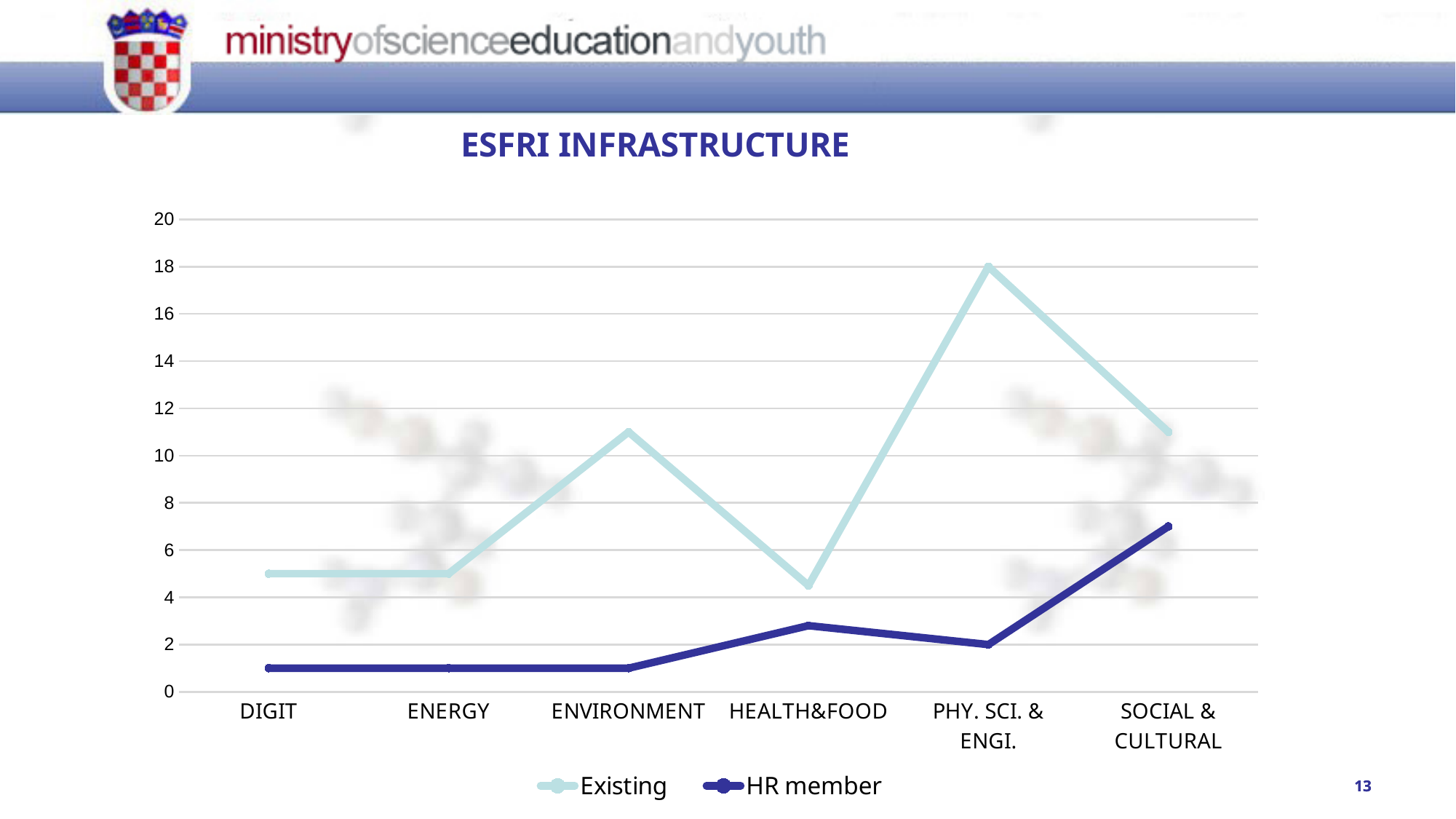
What kind of chart is shown on the slide? Line chart Which category has the highest Existing value? PHY. SCI. & ENGI. For SOCIAL & CULTURAL, which series has the larger value, Existing or HR member? Existing What is the HR member value for PHY. SCI. & ENGI.? 2 What is the Existing value for PHY. SCI. & ENGI.? 18 Does the HR member line rise or fall from PHY. SCI. & ENGI. to SOCIAL & CULTURAL? Rises What is the title of the chart? ESFRI INFRASTRUCTURE How many categories are shown on the x axis? 6 Is the Existing value for ENVIRONMENT greater or less than 10? greater How many series does the legend list? 2 Is the HR member value for DIGIT greater or less than 2? less Which category has the highest HR member value? SOCIAL & CULTURAL